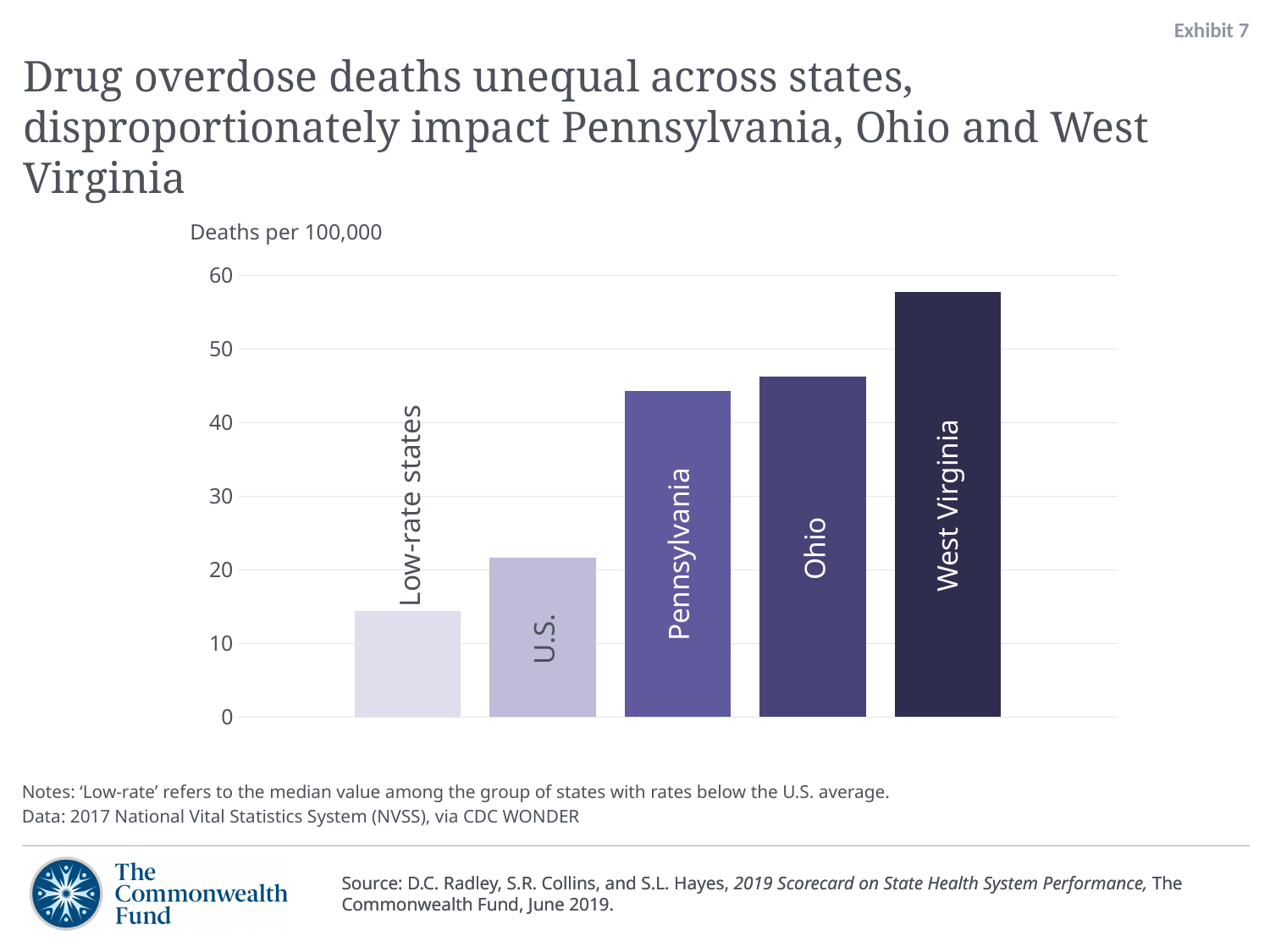
Which has a higher death rate, Ohio or West Virginia? West Virginia What unit is the y axis of the chart measured in? Deaths per 100,000 Is the value for Low-rate states greater or less than 20? less Is the value for Pennsylvania greater or less than 40? greater Is the value for West Virginia greater or less than 50? greater Which category has the highest drug overdose death rate? West Virginia What kind of chart is shown on the slide? Bar chart Which category has the lowest drug overdose death rate? Low-rate states Do the bar values rise or fall from left to right across the chart? Rise How many bars are plotted in the chart? 5